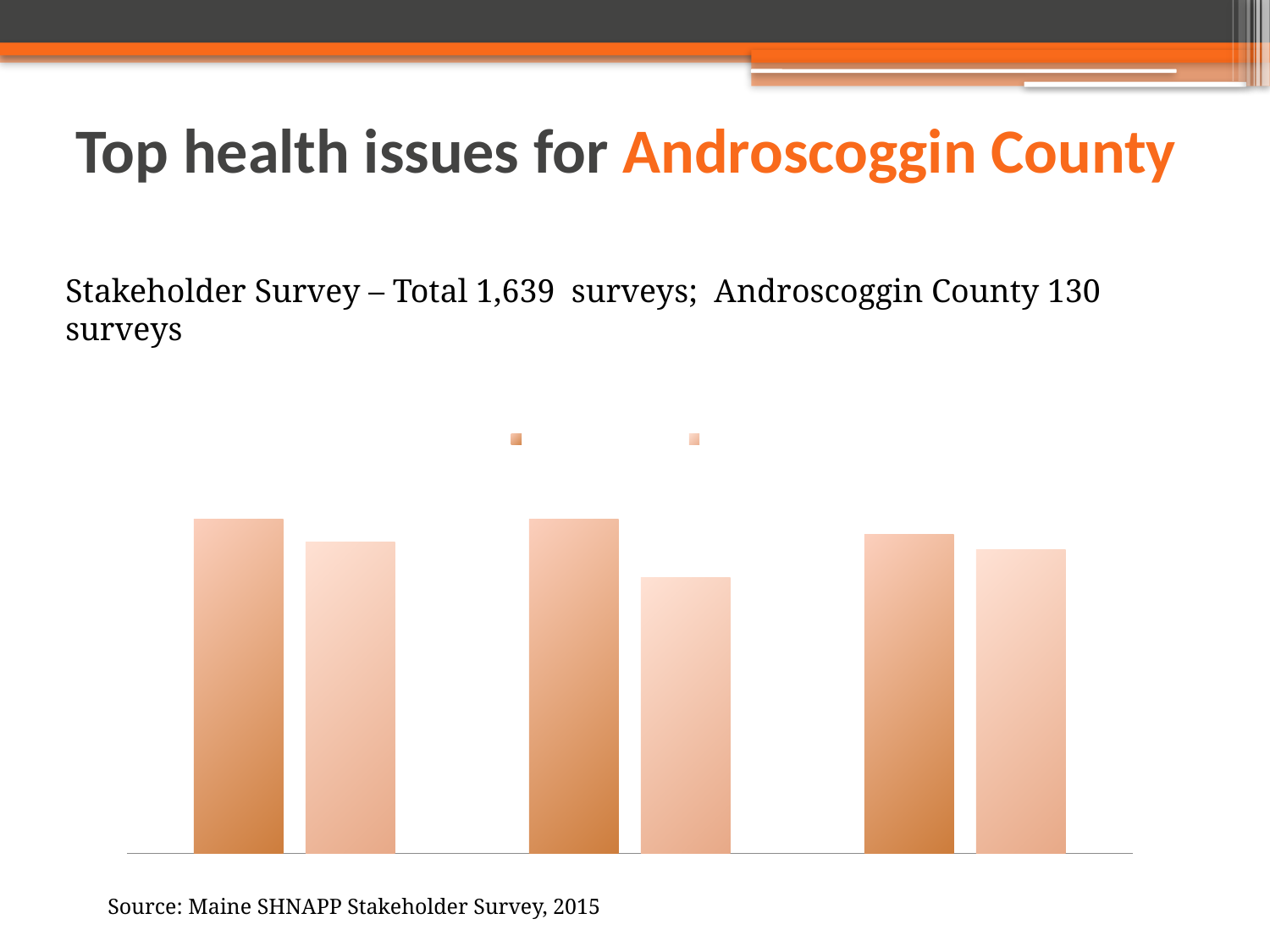
How many bars in total are plotted in the chart? 6 Is the darker orange bar in every group taller than the lighter orange bar next to it? yes How many series does the chart's legend indicate? 2 What colours are the two series in the chart? darker orange and lighter orange In the middle group of bars, which bar is taller, the darker orange bar or the lighter orange bar? the darker orange bar What kind of chart is shown on the slide? bar chart Among the three lighter orange bars, which group has the shortest one? the middle group Does the chart display any numeric axis values or data labels? no In the third (rightmost) group of bars, which bar is taller, the darker orange bar or the lighter orange bar? the darker orange bar How many groups of bars are plotted in the chart? 3